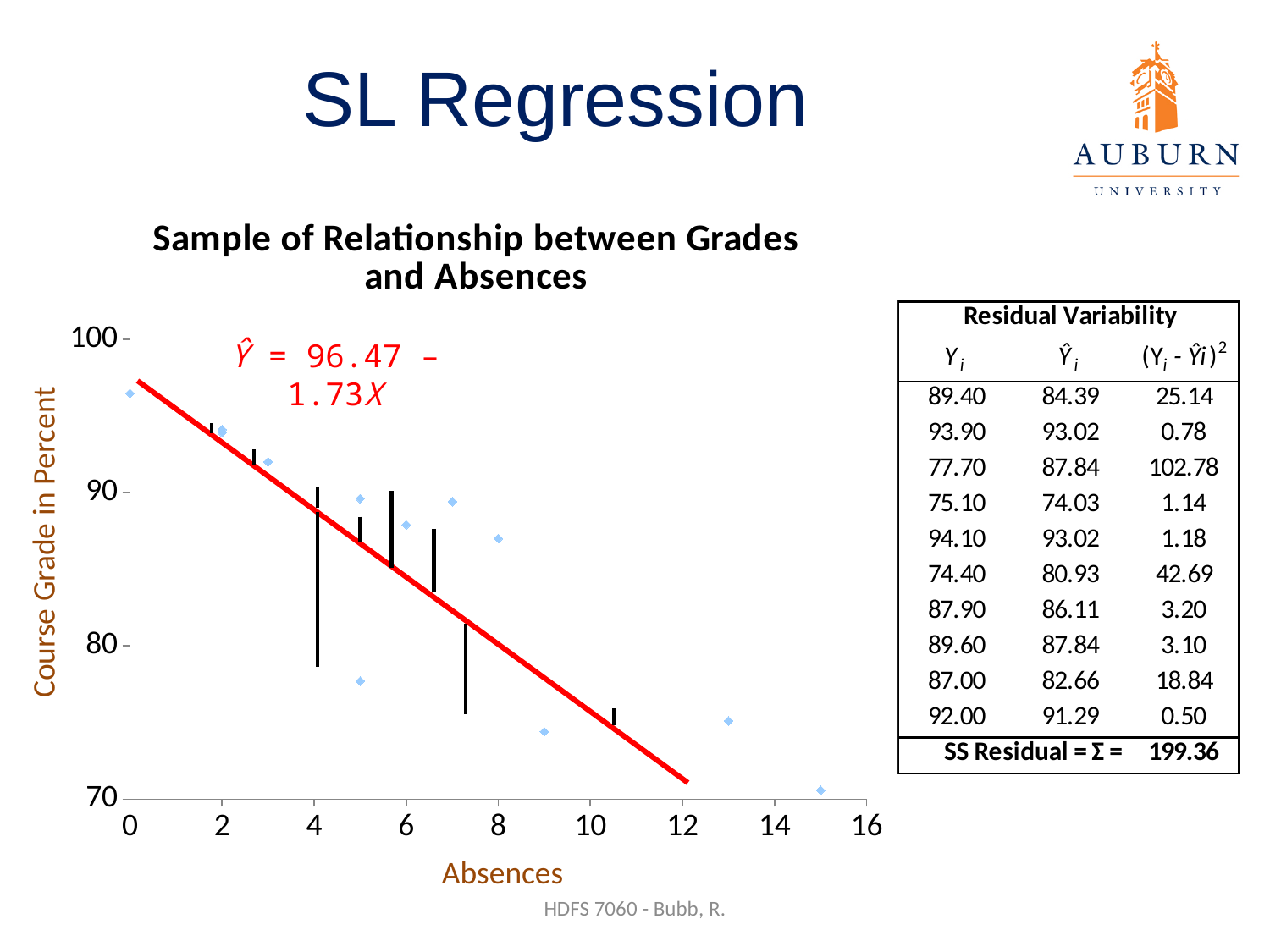
Which point has the higher course grade: the one at 0 absences or the one at 15 absences? 0 absences At how many absences is the lowest course grade plotted? 15 What kind of chart is shown on the slide? scatter chart Is the course grade for the point at 9 absences greater or less than 80? less What is the title of the chart? Sample of Relationship between Grades and Absences Is the course grade for the point at 0 absences greater or less than 90? greater What regression equation is printed on the chart? Ŷ = 96.47 – 1.73X At how many absences is the highest course grade plotted? 0 As the number of absences increases along the x axis, do course grades generally rise or fall? fall Is the course grade for the point at 15 absences greater or less than 80? less